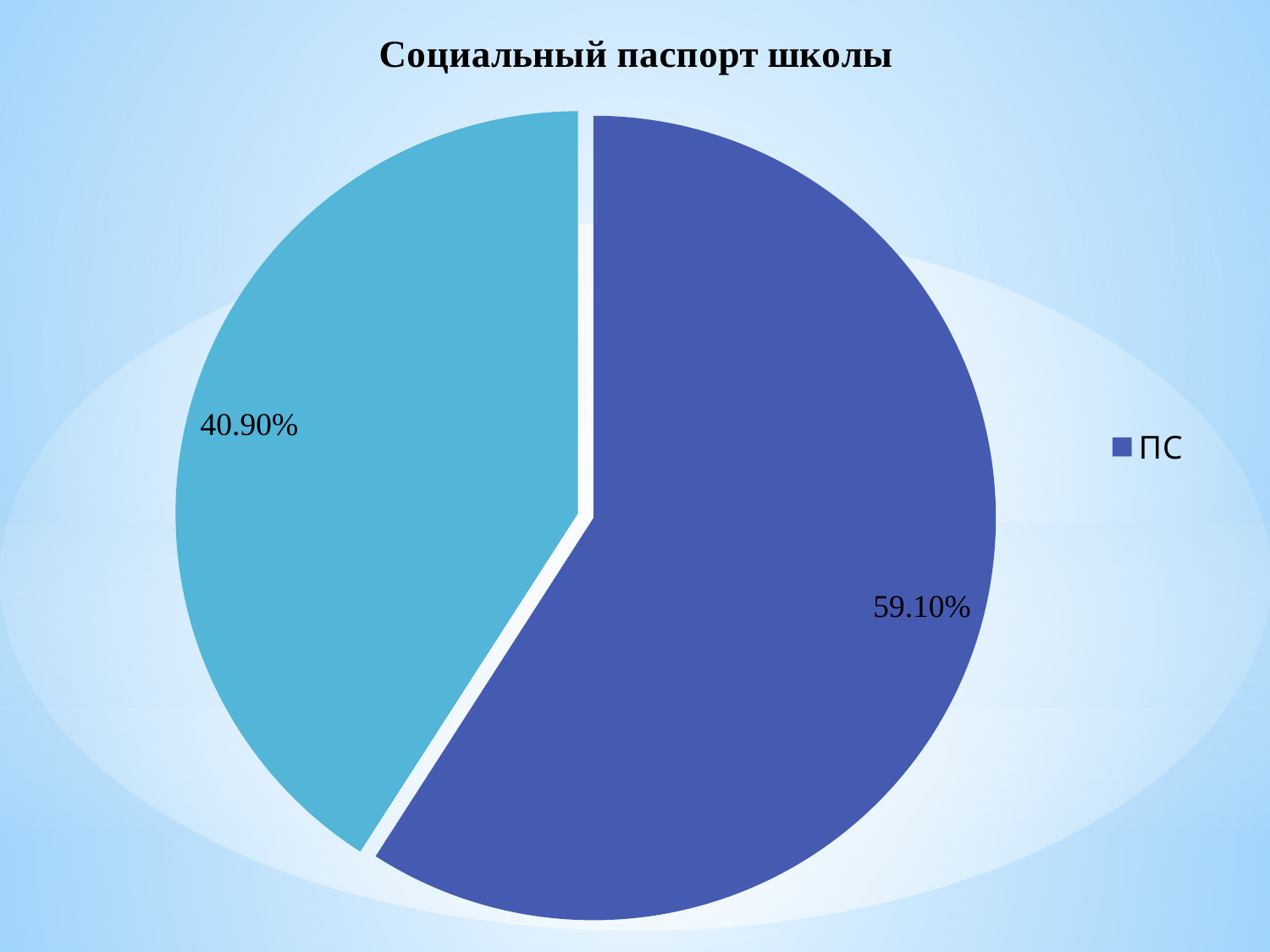
Is the value of the ПС slice greater or less than 50%? greater What kind of chart is shown on the slide? pie chart What colour is the ПС slice in the pie chart? dark blue What value is printed on the light blue slice of the pie? 40.90% Which slice is the largest in the pie chart? ПС What is the difference between the two slice values in the pie chart? 18.20% What is the title of the chart? Социальный паспорт школы What share of the pie does the ПС slice represent? 59.10% How many entries does the legend list? 1 Which is larger: the ПС slice or the light blue slice? ПС What is the value of the smallest slice in the pie chart? 40.90% How many slices does the pie chart have? 2